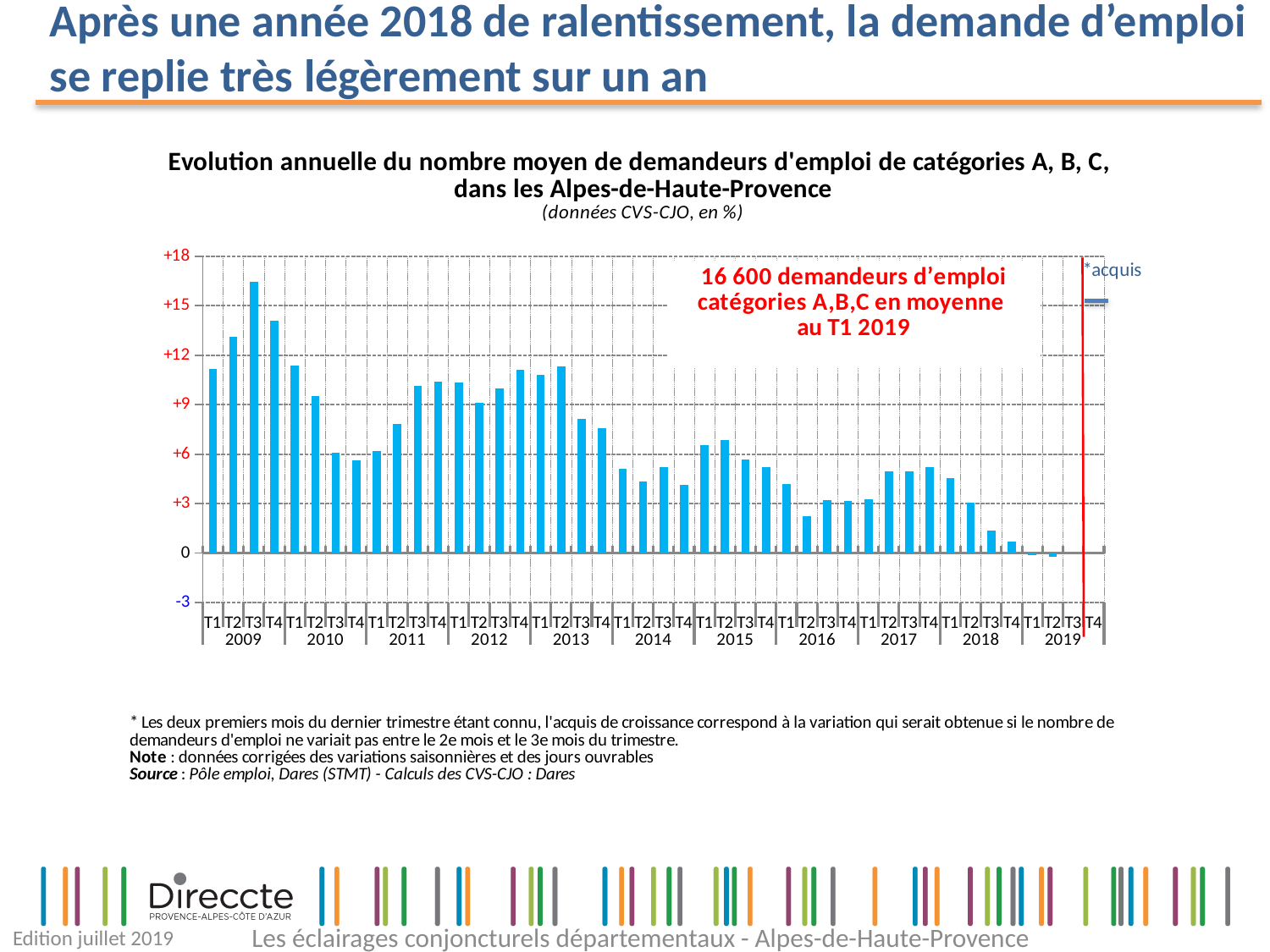
Is the value for T3 2009 greater or less than +15? greater Is the value for T1 2011 greater or less than +9? less How many years are labelled on the x axis of the chart? 11 Which quarter has the highest value in the chart? T3 2009 Which is larger, the value for T1 2011 or the value for T1 2014? T1 2011 According to the annotation on the chart, how many demandeurs d'emploi catégories A,B,C were there on average in T1 2019? 16 600 Which is larger, the value for T2 2013 or the value for T1 2016? T2 2013 Is the value for T1 2016 greater or less than +3? greater Overall, do the values rise or fall from 2009 to 2018? fall What kind of chart is shown on the slide? Bar chart